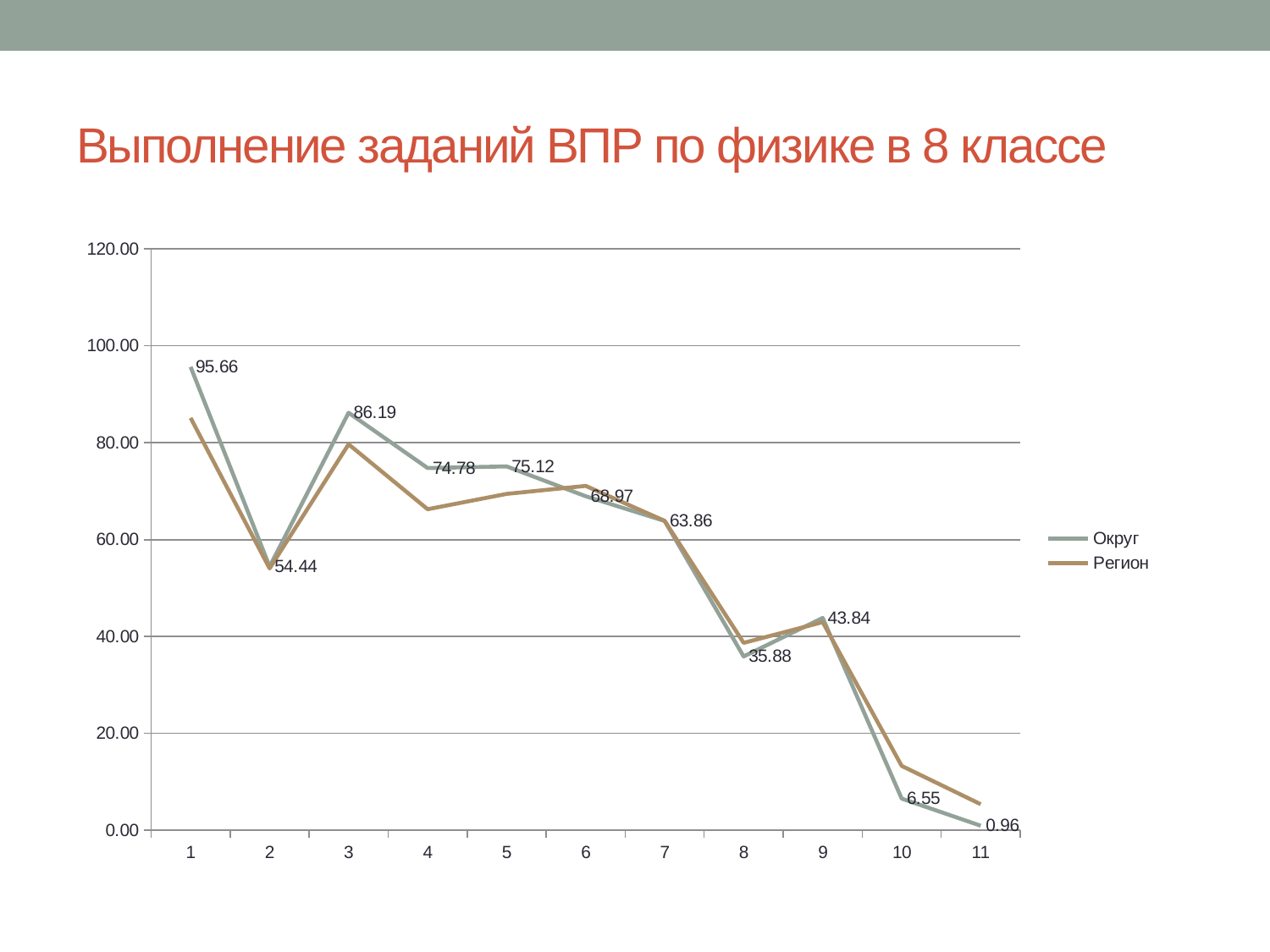
How many tasks are shown on the x axis? 11 How many series does the legend list? 2 For which task is the Округ series lowest? 11 What is the value of the Округ series for task 11? 0.96 What is the value of the Округ series for task 1? 95.66 Is the value of the Регион series for task 10 greater or less than 20? less Is the value of the Регион series for task 1 greater or less than 80? greater What is the difference between the Округ values for task 1 and task 2? 41.22 What kind of chart is shown on the slide? line chart Which is larger for the Округ series: the value for task 4 or for task 5? task 5 For which task is the Округ series highest? 1 What is the value of the Округ series for task 8? 35.88